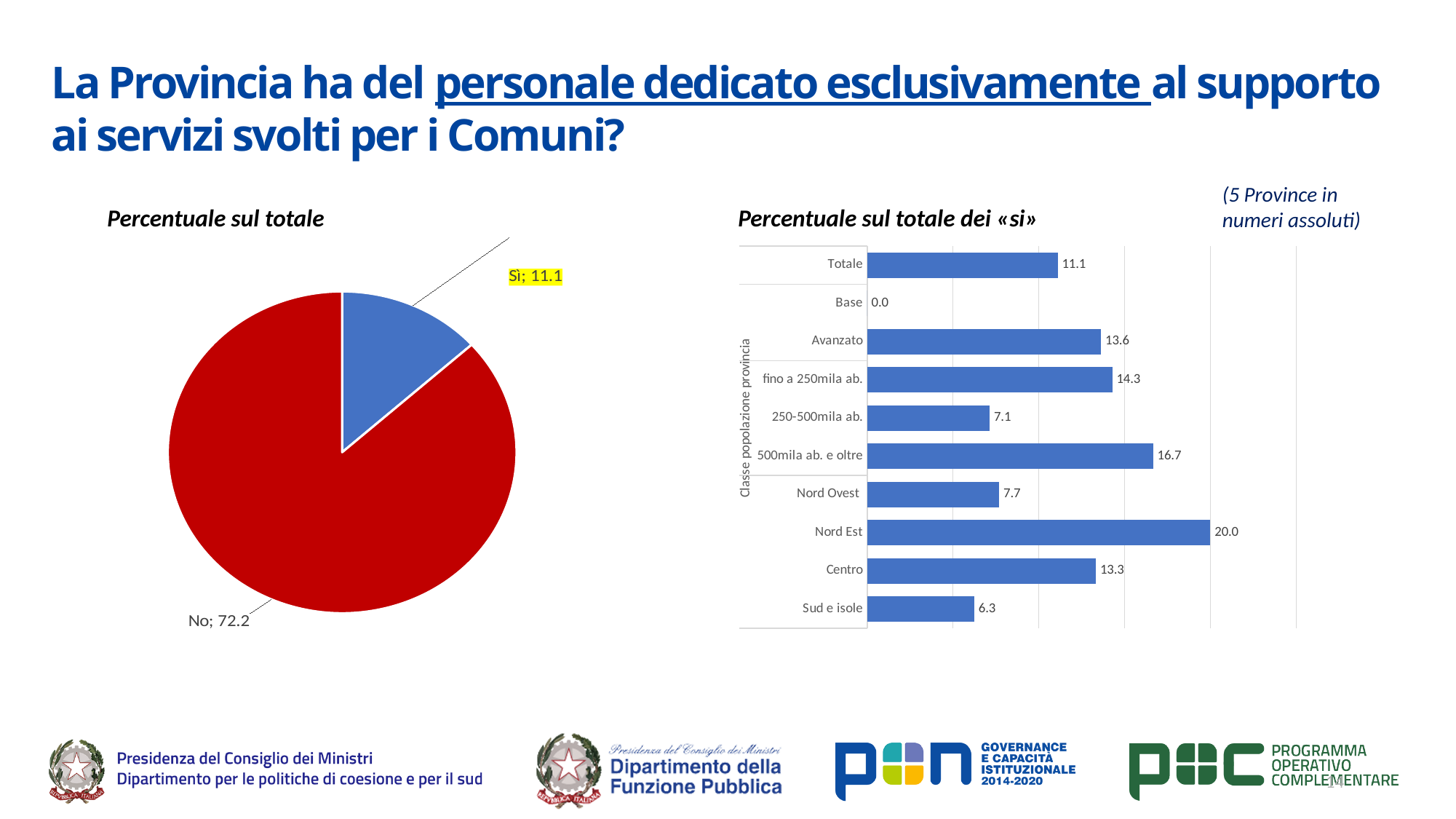
In the bar chart 'Percentuale sul totale dei «si»', what is the value for '250-500mila ab.'? 7.1 What kind of chart is the chart on the right, 'Percentuale sul totale dei «si»'? bar chart How many categories are shown in the bar chart 'Percentuale sul totale dei «si»'? 10 In the bar chart 'Percentuale sul totale dei «si»', what is the value for '500mila ab. e oltre'? 16.7 In the pie chart 'Percentuale sul totale', what is the value for 'No'? 72.2 In the bar chart 'Percentuale sul totale dei «si»', which is larger, the value for 'Avanzato' or the value for 'Centro'? Avanzato In the bar chart 'Percentuale sul totale dei «si»', what is the difference between the values for 'Nord Est' and 'Sud e isole'? 13.7 In the bar chart 'Percentuale sul totale dei «si»', which category has the highest value? Nord Est In the bar chart 'Percentuale sul totale dei «si»', what is the value for 'Nord Est'? 20.0 In the pie chart 'Percentuale sul totale', what is the value for 'Sì'? 11.1 In the bar chart 'Percentuale sul totale dei «si»', which category has the lowest value? Base What kind of chart is the chart on the left, 'Percentuale sul totale'? pie chart